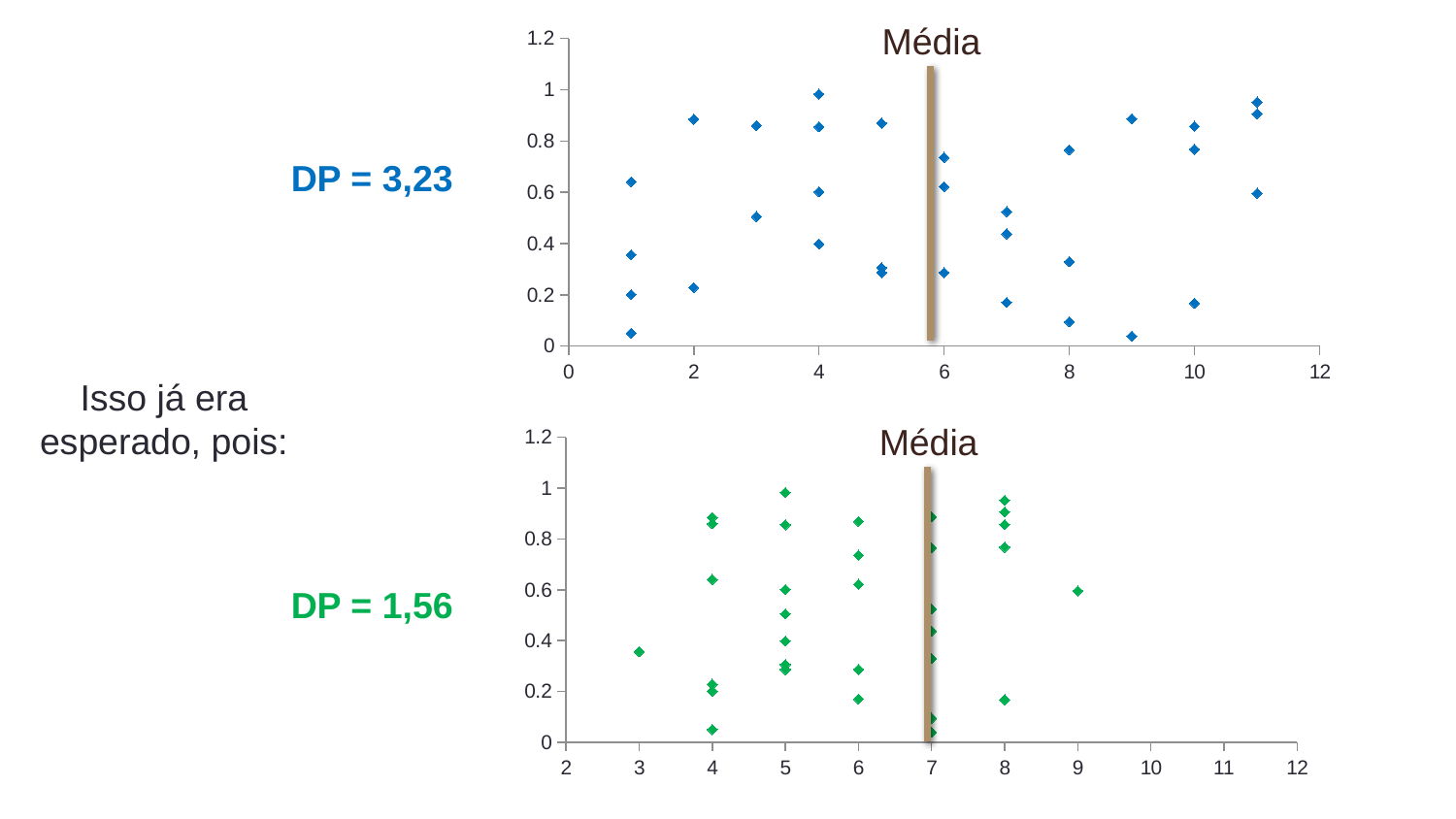
In the top chart, how many points are plotted at x = 1? 4 What kind of chart is the top chart on the slide? Scatter chart What label is written above the vertical bar in each chart? Média In the bottom chart, how many points are plotted at x = 9? 1 In the top chart, is the lowest point at x = 9 greater or less than 0.2? less In the top chart, is the lowest point at x = 11 greater or less than 0.4? greater What kind of chart is the bottom chart on the slide? Scatter chart In the bottom chart, is the single point at x = 3 greater or less than 0.4? less What is the highest value shown on the y axis of the top chart? 1.2 In the bottom chart, how many points are plotted at x = 3? 1